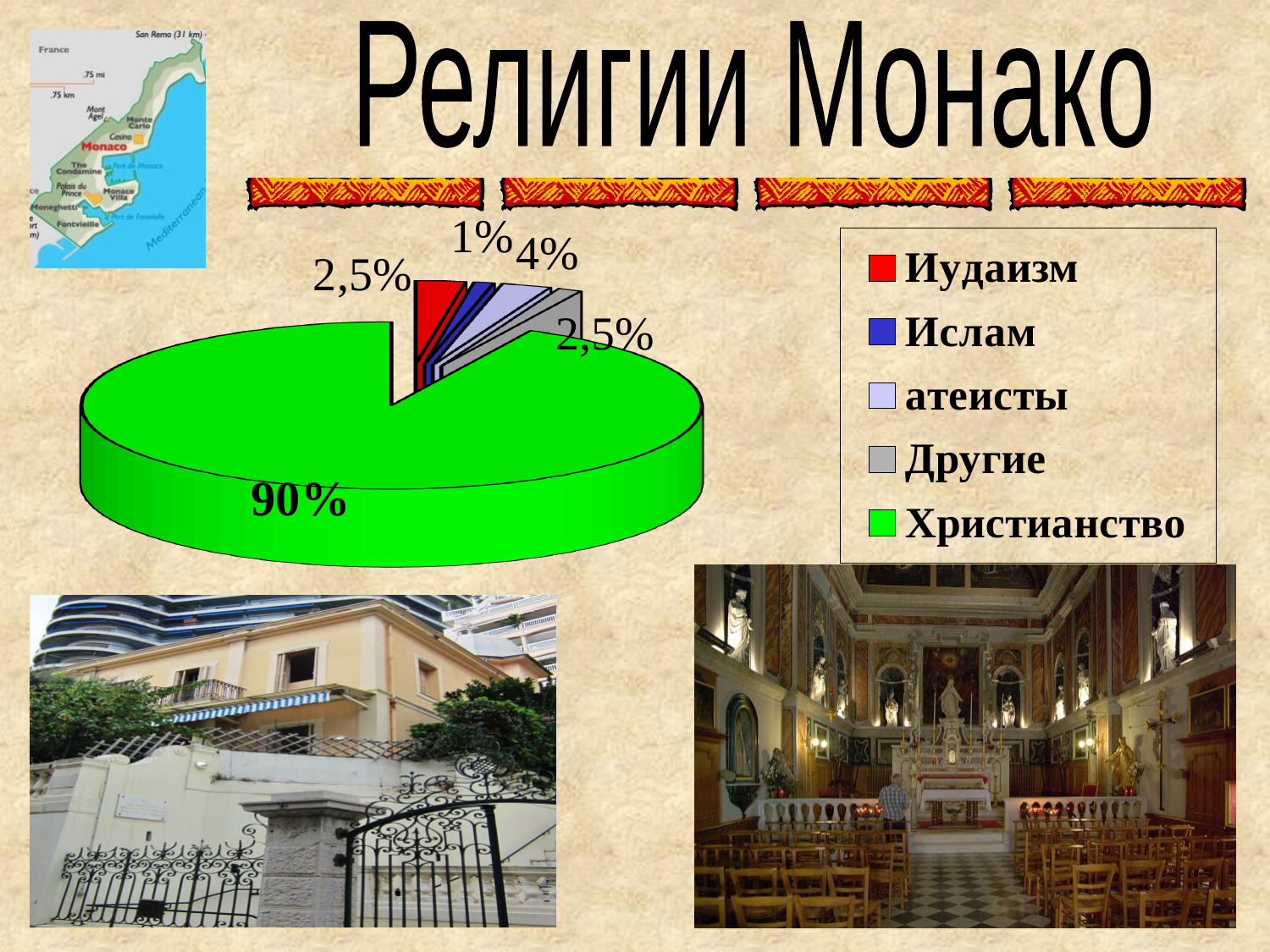
Which category has the smallest slice of the pie? Ислам What value is shown for Другие? 2,5% What type of chart is shown on the slide? pie chart What percentage of the pie is Христианство? 90% What is the title of the chart? Религии Монако What is the difference between the values for Христианство and атеисты? 86% What value is shown for Иудаизм? 2,5% How many categories does the legend list? 5 Which is larger, the value for атеисты or the value for Ислам? атеисты What value is shown for Ислам? 1% What value is shown for атеисты? 4% Which category has the largest slice of the pie? Христианство